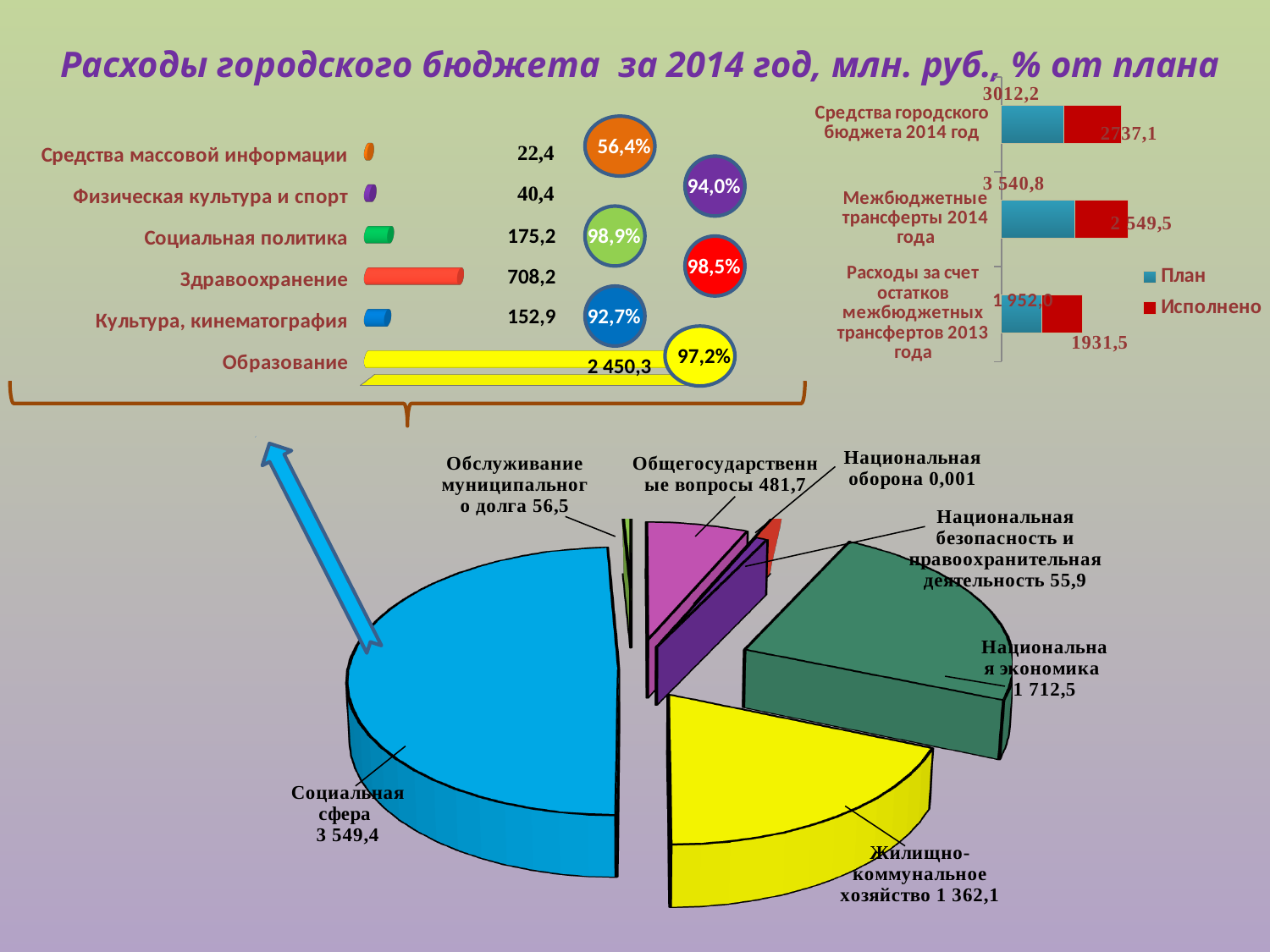
In the top-right chart, how many series does the legend list? 2 In the top-left bar chart, what is the difference between the values for Социальная политика and Культура, кинематография? 22,3 In the bottom pie chart, which slice is the largest? Социальная сфера In the top-left bar chart, what is the value for Образование? 2 450,3 In the top-left bar chart, which category has the highest value? Образование In the top-left bar chart, how many categories are shown? 6 In the top-left bar chart, which category has the lowest value? Средства массовой информации In the top-left bar chart, what is the value for Здравоохранение? 708,2 In the top-right chart (План vs Исполнено), what is the Исполнено value for Расходы за счет остатков межбюджетных трансфертов 2013 года? 1931,5 In the top-right chart, which is larger for Межбюджетные трансферты 2014 года: План or Исполнено? План In the top-right chart (План vs Исполнено), what is the План value for Межбюджетные трансферты 2014 года? 3 540,8 In the bottom pie chart, what is the value for Жилищно-коммунальное хозяйство? 1 362,1